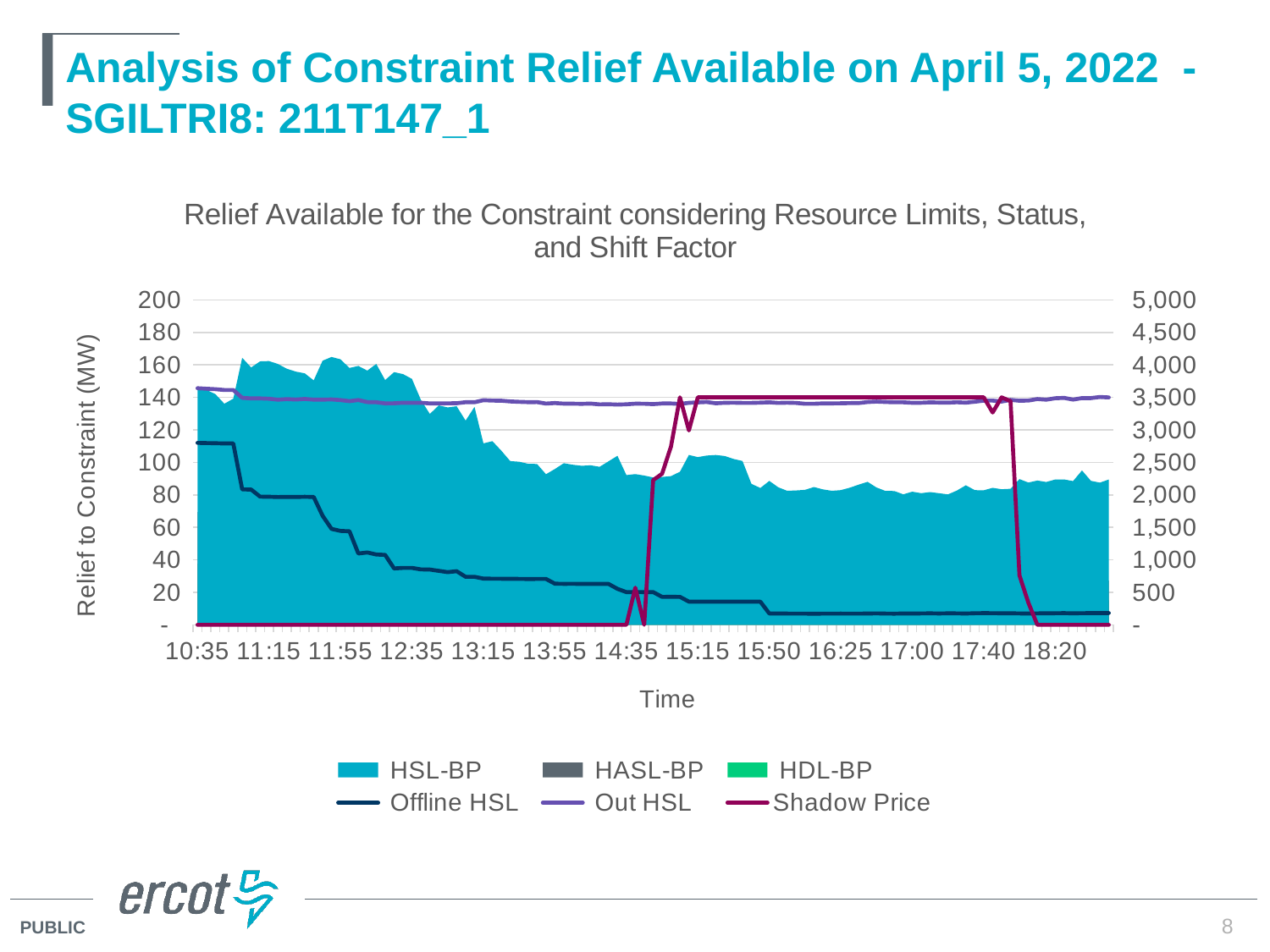
Is the Offline HSL value at 10:35 greater or less than 100? greater What is the label of the left vertical axis? Relief to Constraint (MW) Is the Shadow Price at 16:25 greater or less than 3,000 on the right axis? greater Which is larger, the Offline HSL value at 10:35 or at 18:20? 10:35 What kind of chart is shown on the slide? Combination area and line chart Is the HSL-BP value at 11:55 greater or less than 140? greater Does the Offline HSL line rise or fall from 10:35 to 18:20? Fall What is the label of the horizontal axis? Time How many series does the chart legend list? 6